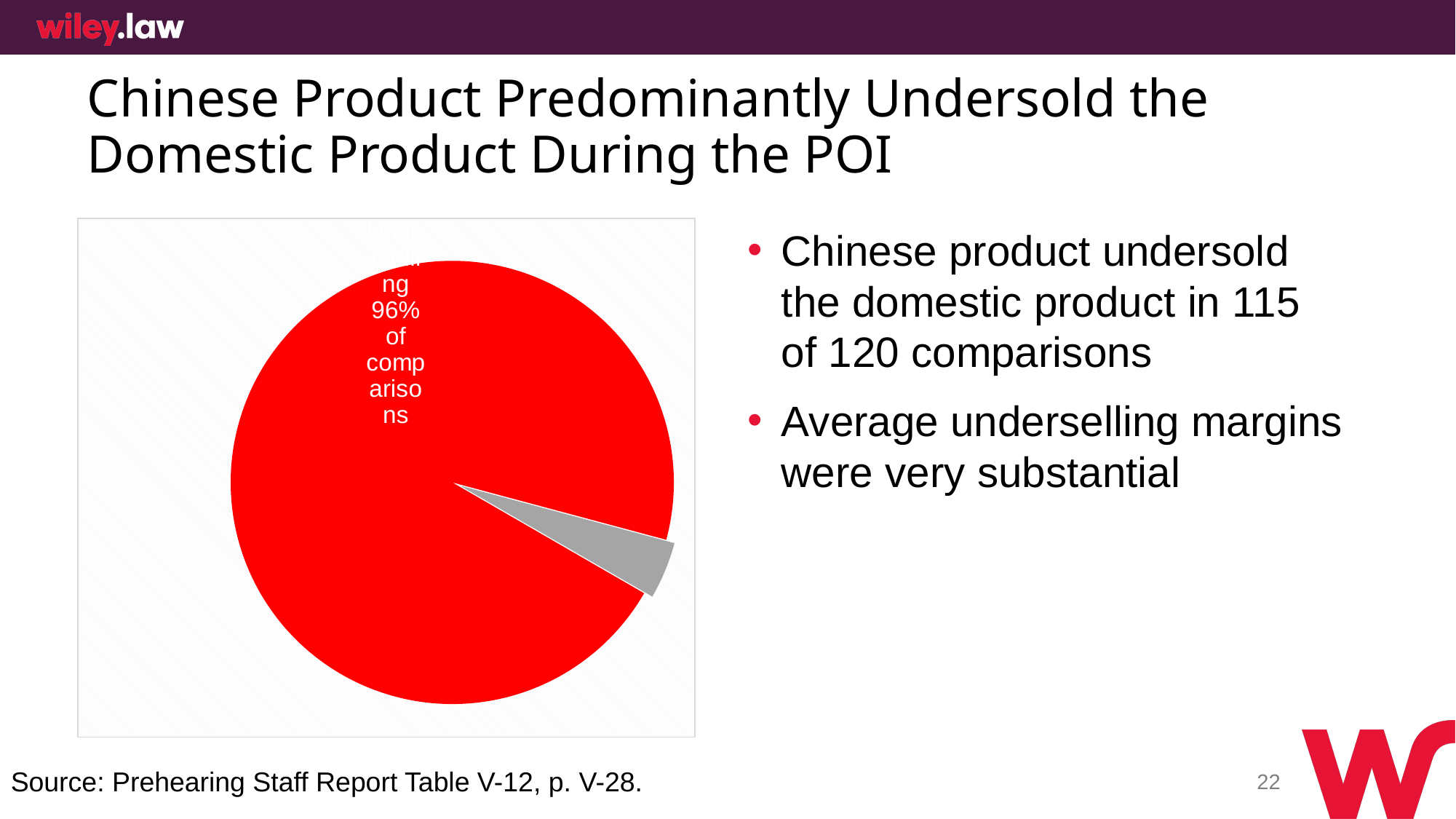
Which slice of the pie chart is the largest? Underselling How many slices does the pie chart have? 2 What kind of chart is shown on the slide? Pie chart Which slice is larger in the pie chart, the red slice or the gray slice? The red slice What colour is the Underselling slice in the pie chart? Red What share of comparisons does the Underselling slice of the pie chart represent? 96% Does the pie chart show a legend? No Which slice of the pie chart is the smallest? The gray slice